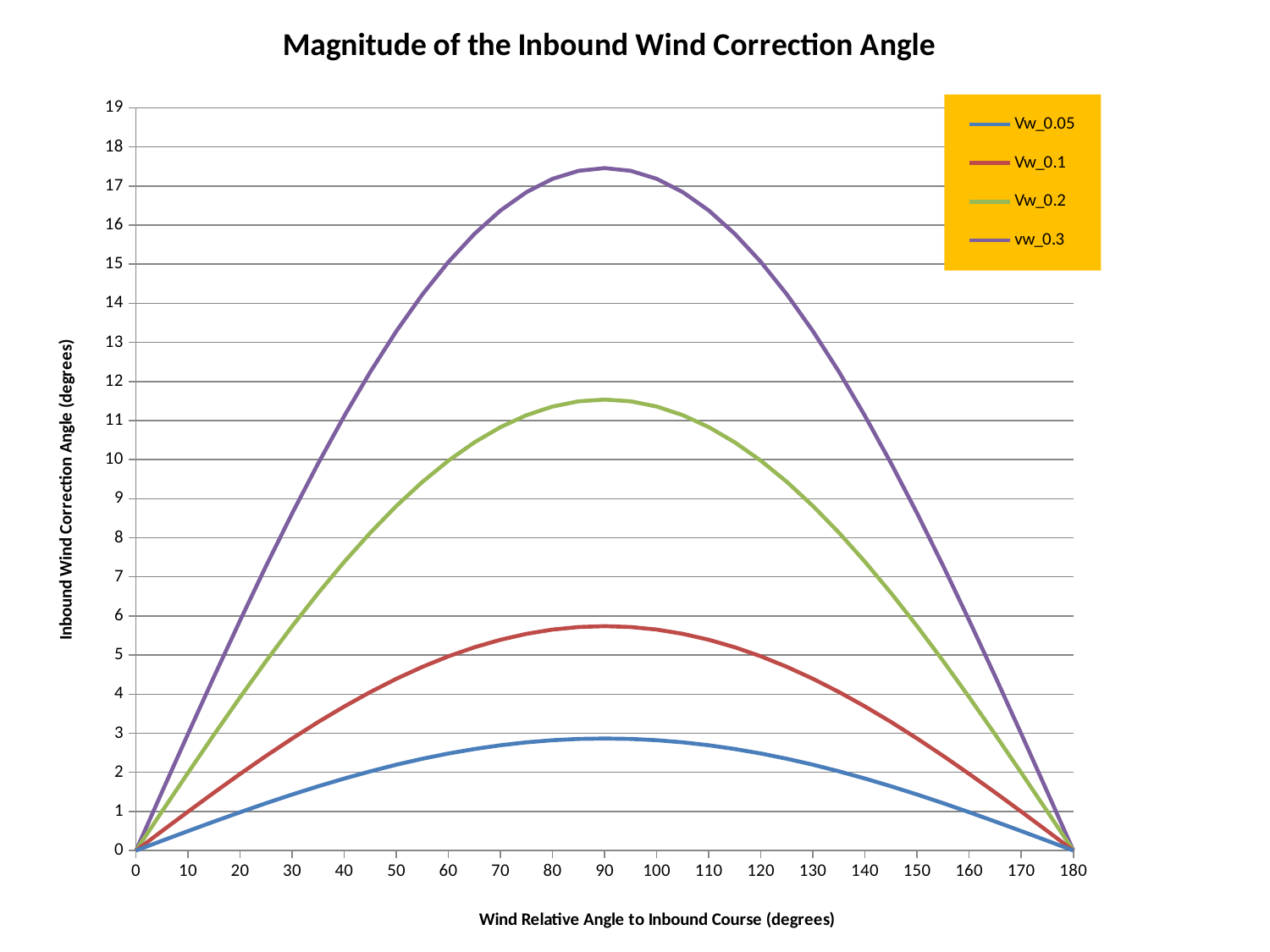
What is the title of the chart? Magnitude of the Inbound Wind Correction Angle What is the value of the vw_0.3 series at a wind relative angle of 180 degrees? 0 Which series has the lowest peak inbound wind correction angle? Vw_0.05 Is the peak value of the vw_0.3 series greater or less than 17? greater What is the label of the x axis? Wind Relative Angle to Inbound Course (degrees) Is the peak value of the Vw_0.2 series greater or less than 12? less Is the peak value of the Vw_0.05 series greater or less than 3? less How many series does the legend list? 4 At a wind relative angle of 90 degrees, which is larger: the value for Vw_0.2 or the value for Vw_0.1? Vw_0.2 What kind of chart is shown on the slide? line chart Which series reaches the highest inbound wind correction angle? vw_0.3